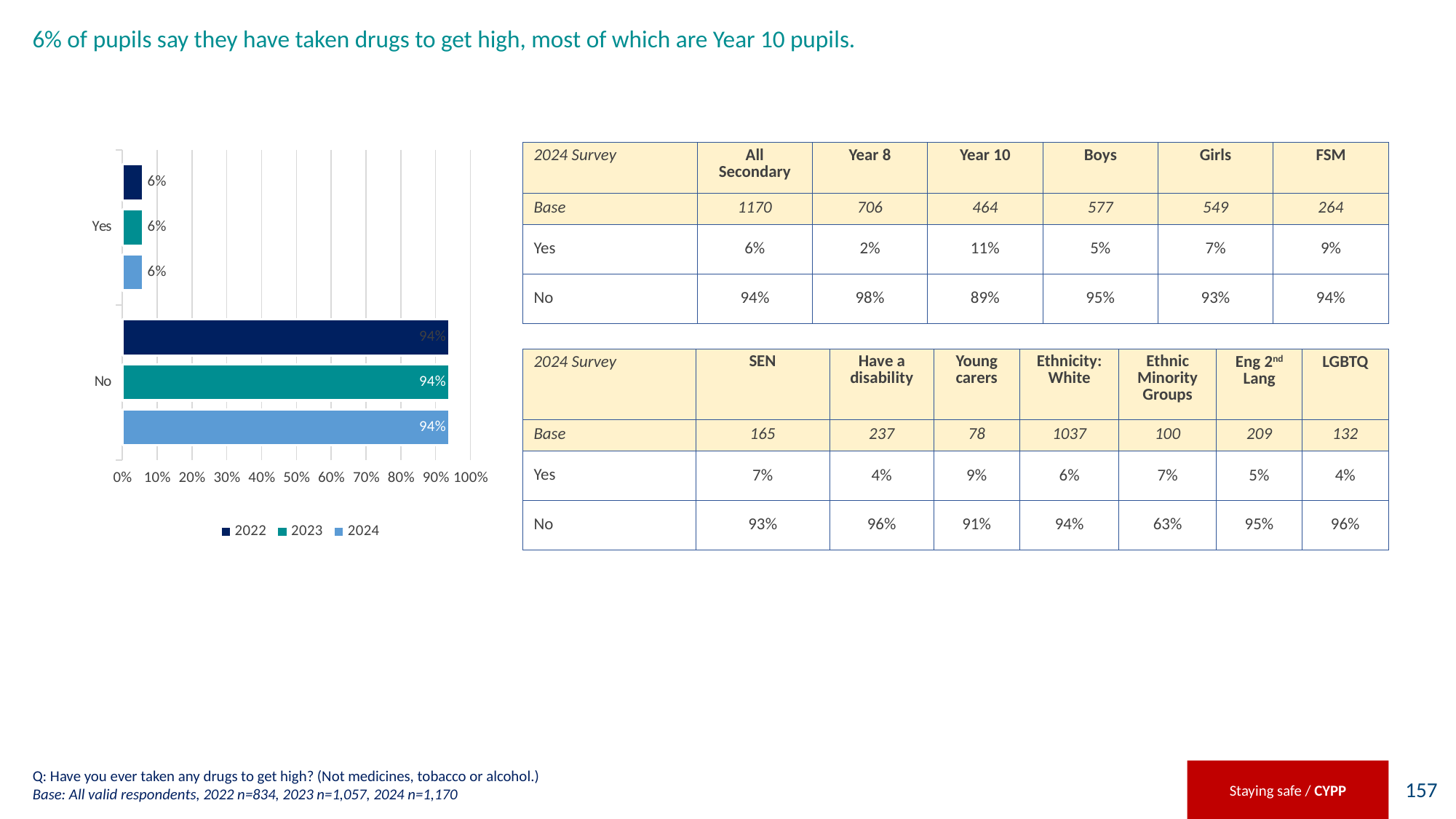
Which category has the higher value in the 2023 series, 'Yes' or 'No'? No How many categories are shown on the chart's vertical axis? 2 What is the difference between the 'No' and 'Yes' values in the 2024 series? 88% What is the value for 'No' in the 2022 series? 94% Which years are listed in the chart legend? 2022, 2023, 2024 What is the value for 'Yes' in the 2024 series? 6% What is the value for 'No' in the 2024 series? 94% What kind of chart is shown on the slide? bar chart How many series does the chart legend list? 3 Is the value for 'No' in the 2022 series greater or less than 50%? greater What is the value for 'Yes' in the 2023 series? 6% Which category has the lowest value across all series in the chart? Yes